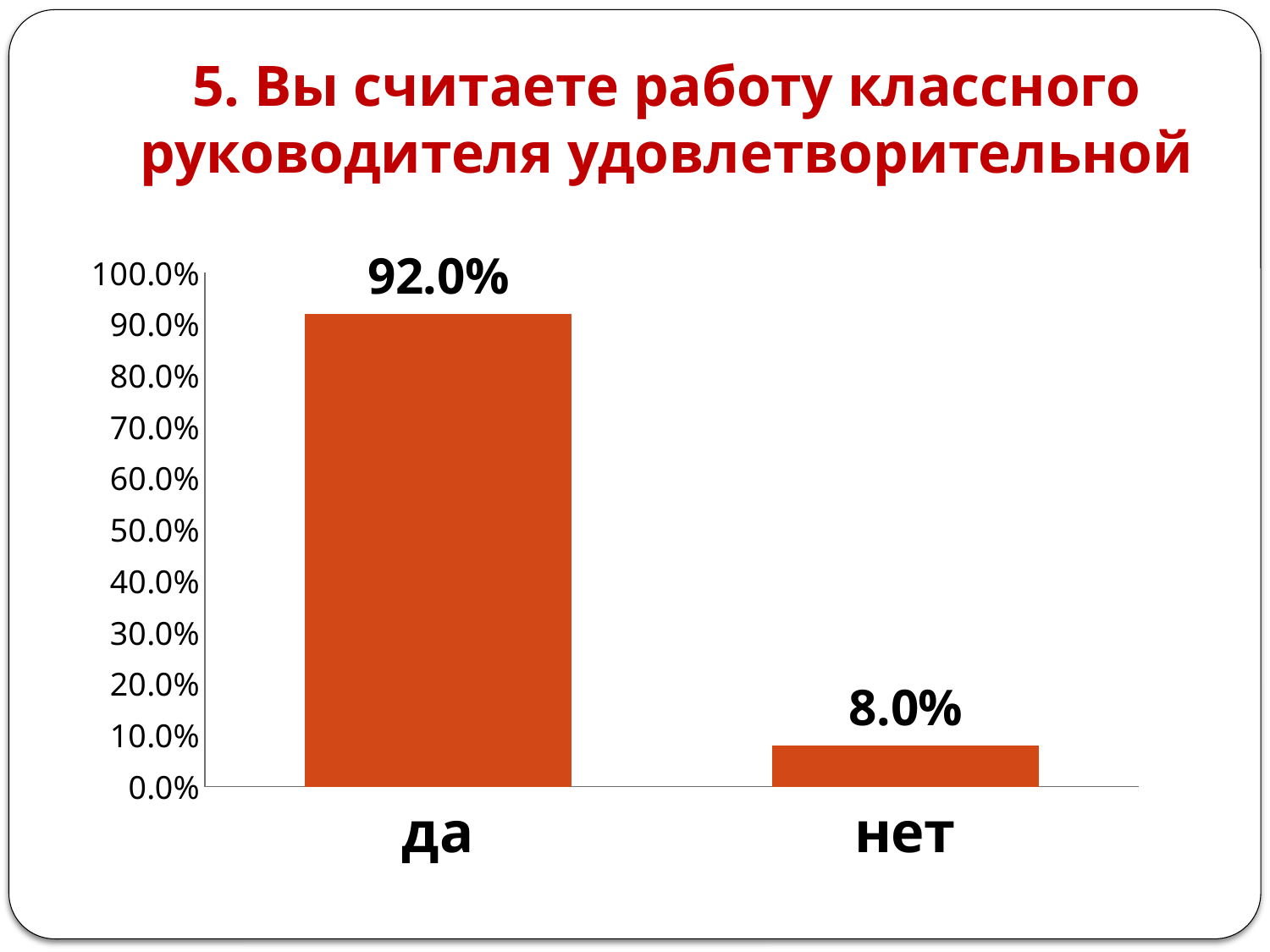
What is the maximum value shown on the y axis? 100.0% What kind of chart is shown on the slide? bar chart Is the value for "да" greater or less than 90.0%? greater How many categories are shown on the x axis? 2 What is the value for "нет"? 8.0% Is the value for "нет" greater or less than 10.0%? less What is the value for "да"? 92.0% Which category has the highest value? да What is the difference between the values for "да" and "нет"? 84.0% Which category has the lowest value? нет What colour are the bars in the chart? orange-red Which is larger, the value for "да" or the value for "нет"? да